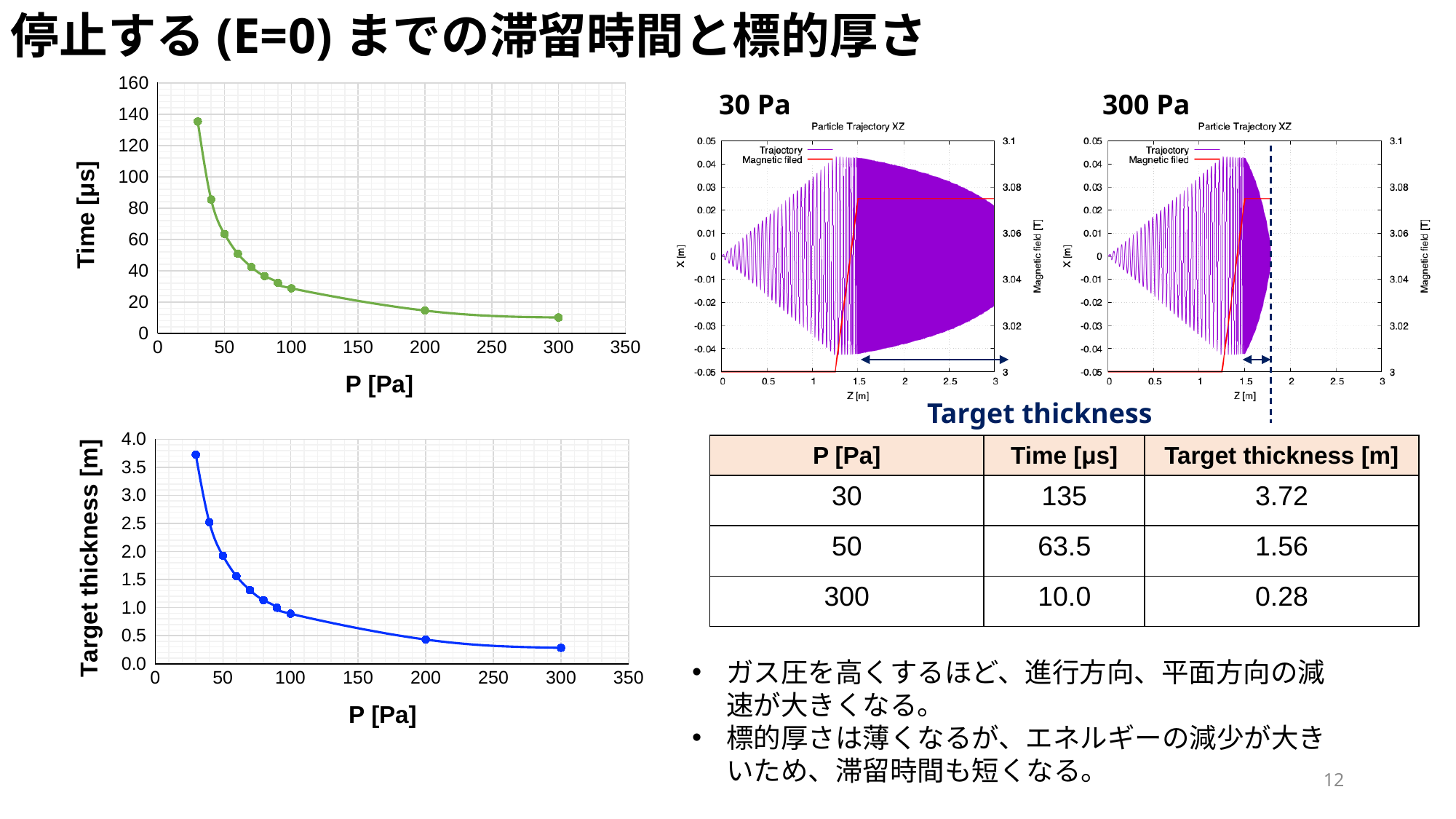
In the bottom-left chart (Target thickness vs P), is the target thickness at P = 100 greater or less than 1.0? less In the top-left chart (Time vs P), does the time rise or fall as P increases? fall In the bottom-left chart (Target thickness vs P), how many data points are plotted? 10 In the bottom-left chart (Target thickness vs P), at which P value is the target thickness lowest? 300 What is the y-axis label of the bottom-left chart? Target thickness [m] In the top-left chart (Time vs P), at which P value is the time highest? 30 In the bottom-left chart (Target thickness vs P), does the target thickness rise or fall as P increases? fall In the top-left chart (Time vs P), is the time at P = 200 greater or less than 20? less What kind of chart is the top-left chart (Time vs P)? line chart In the top-left chart (Time vs P), is the time at P = 100 greater or less than 20? greater In the top-left chart (Time vs P), which has the larger time: P = 50 or P = 300? P = 50 In the top-left chart (Time [μs] vs P [Pa]), how many data points are plotted? 10